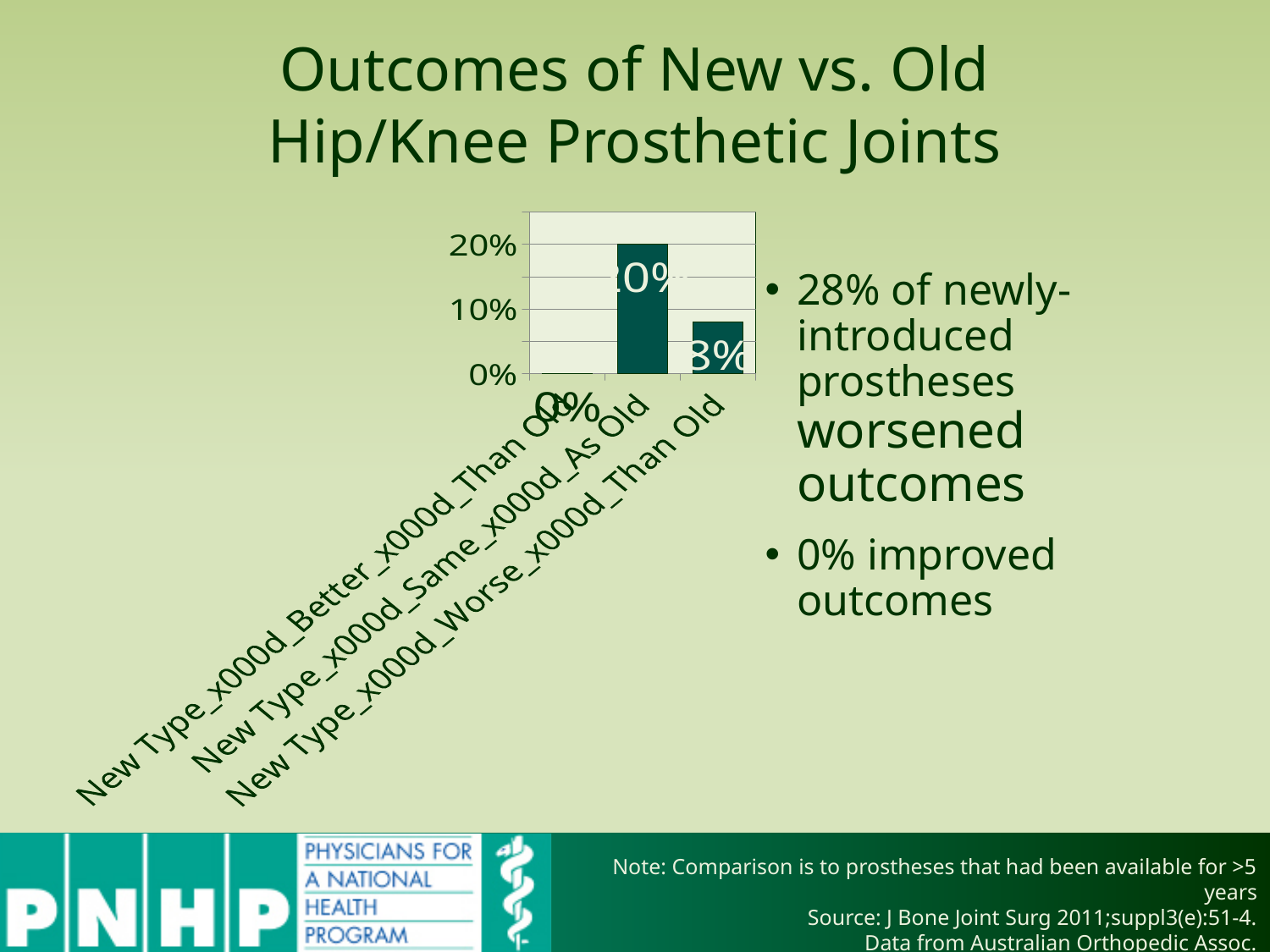
What kind of chart is shown on the slide? bar chart How many categories are plotted in the chart? 3 Which is larger, the value for 'New Type Worse Than Old' or 'New Type Better Than Old'? New Type Worse Than Old Which category has the highest bar in the chart? New Type Same As Old Is the value for 'New Type Same As Old' greater or less than 10%? greater Which is larger, the value for 'New Type Same As Old' or 'New Type Worse Than Old'? New Type Same As Old What is the value for the 'New Type Better Than Old' category? 0% What is the highest value shown on the chart's vertical axis? 20% Which category has the lowest value in the chart? New Type Better Than Old What colour are the bars in the chart? dark green Is the value for 'New Type Worse Than Old' greater or less than 10%? less